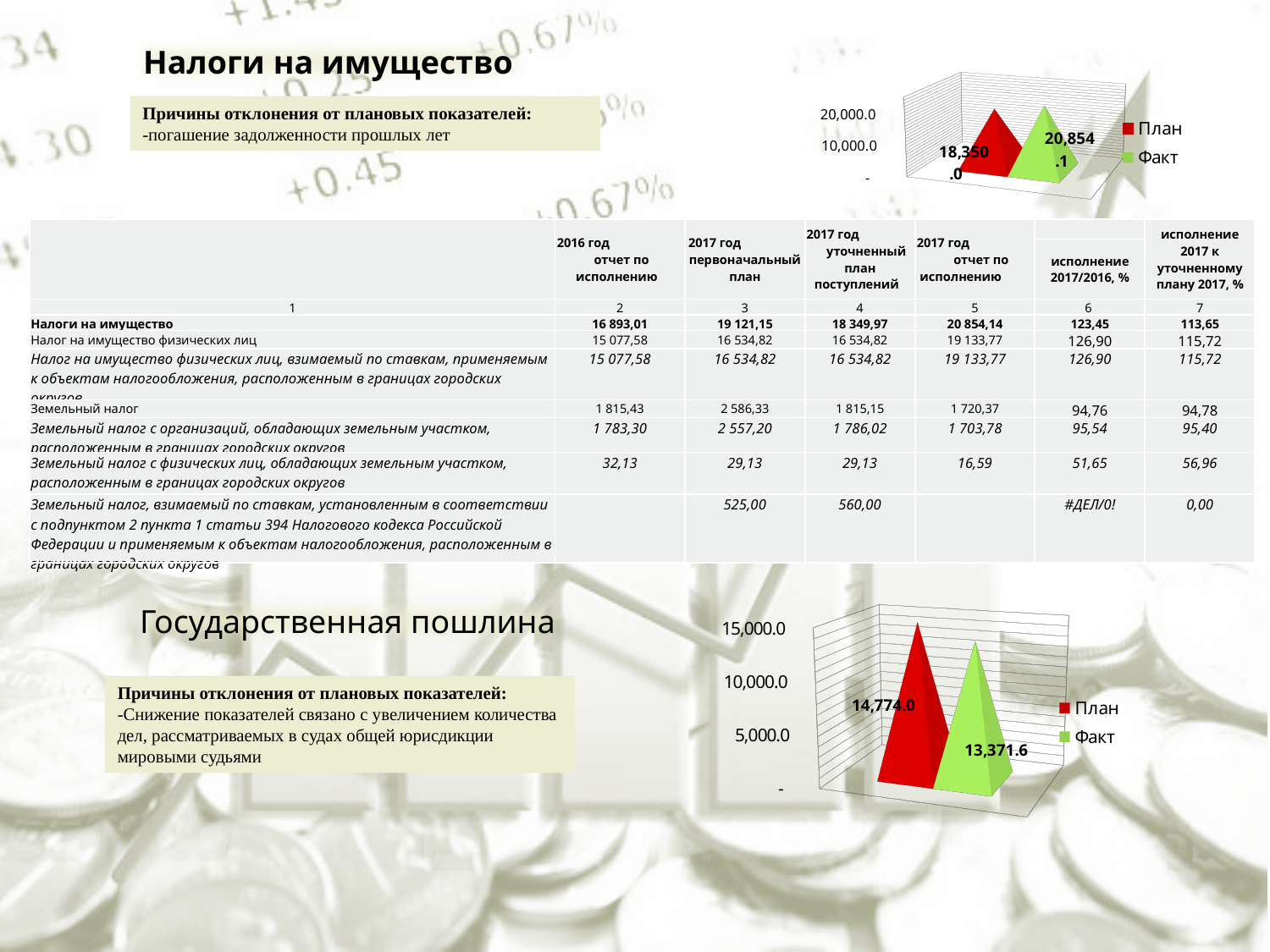
In the top-right chart (Налоги на имущество), what is the value for Факт? 20,854.1 In the bottom-right chart (Государственная пошлина), which series has the lower value? Факт In the top-right chart (Налоги на имущество), what is the difference between Факт and План? 2,504.1 In the bottom-right chart (Государственная пошлина), what is the value for План? 14,774.0 In the bottom-right chart (Государственная пошлина), what is the difference between План and Факт? 1,402.4 In the bottom-right chart (Государственная пошлина), is the value for План greater or less than 15,000.0? less How many series does the legend of the bottom-right chart (Государственная пошлина) list? 2 In the top-right chart (Налоги на имущество), what is the value for План? 18,350.0 In the top-right chart (Налоги на имущество), what colour represents the series Факт? Green In the top-right chart (Налоги на имущество), is the value for Факт greater or less than 20,000.0? greater In the top-right chart (Налоги на имущество), which series has the higher value, План or Факт? Факт In the bottom-right chart (Государственная пошлина), what is the value for Факт? 13,371.6